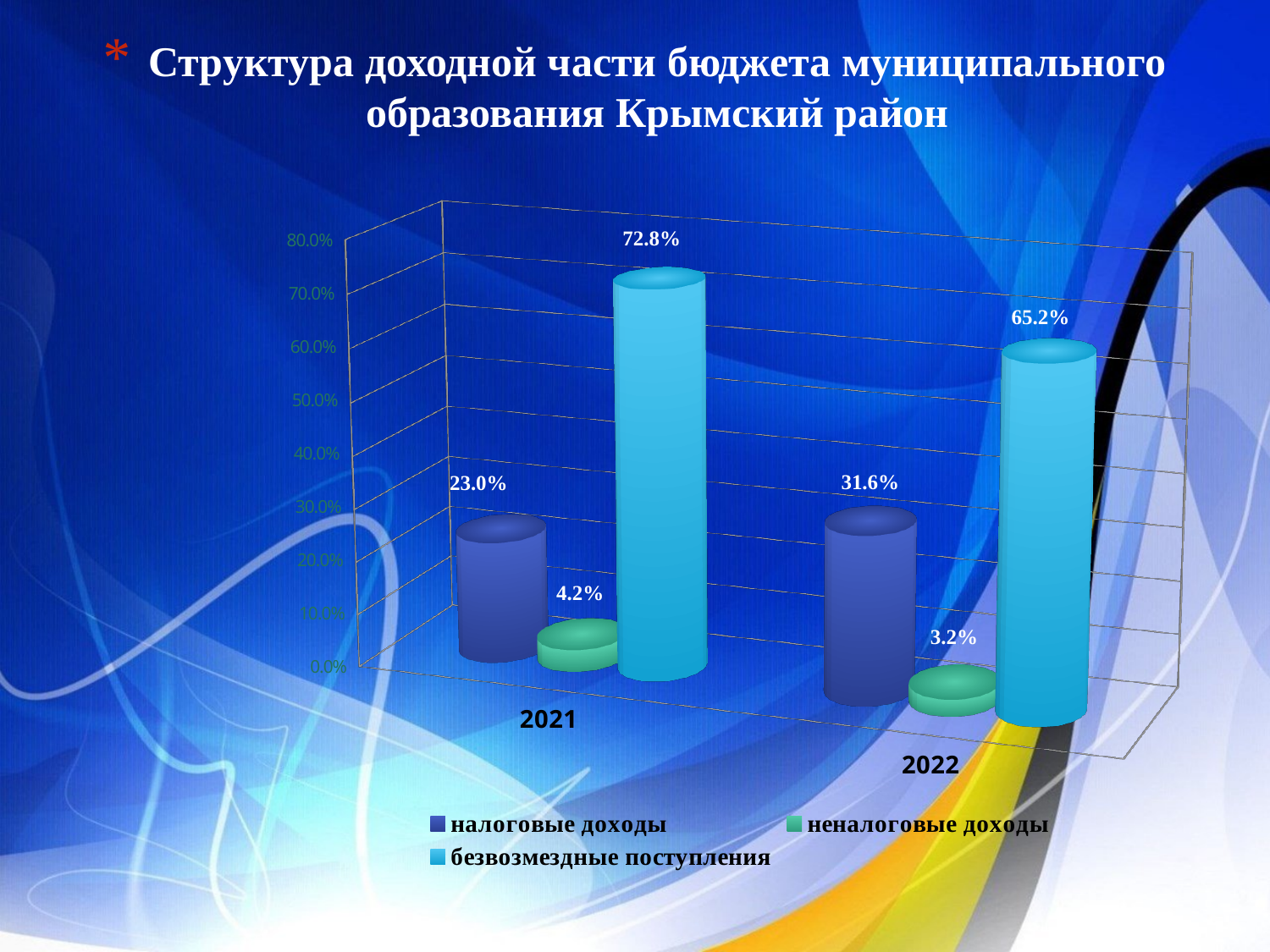
What is the value for неналоговые доходы in 2022? 3.2% What is the difference between налоговые доходы in 2022 and in 2021? 8.6% How many years (categories) are shown on the x axis? 2 What is the value for налоговые доходы in 2021? 23.0% Which series has the highest value in 2021? безвозмездные поступления Does the value for безвозмездные поступления rise or fall from 2021 to 2022? fall What is the value for безвозмездные поступления in 2022? 65.2% Which is larger: налоговые доходы in 2021 or налоговые доходы in 2022? налоговые доходы in 2022 What is the difference between безвозмездные поступления in 2021 and in 2022? 7.6% How many series does the legend list? 3 What kind of chart is shown on the slide? bar chart Which series has the lowest value in 2022? неналоговые доходы